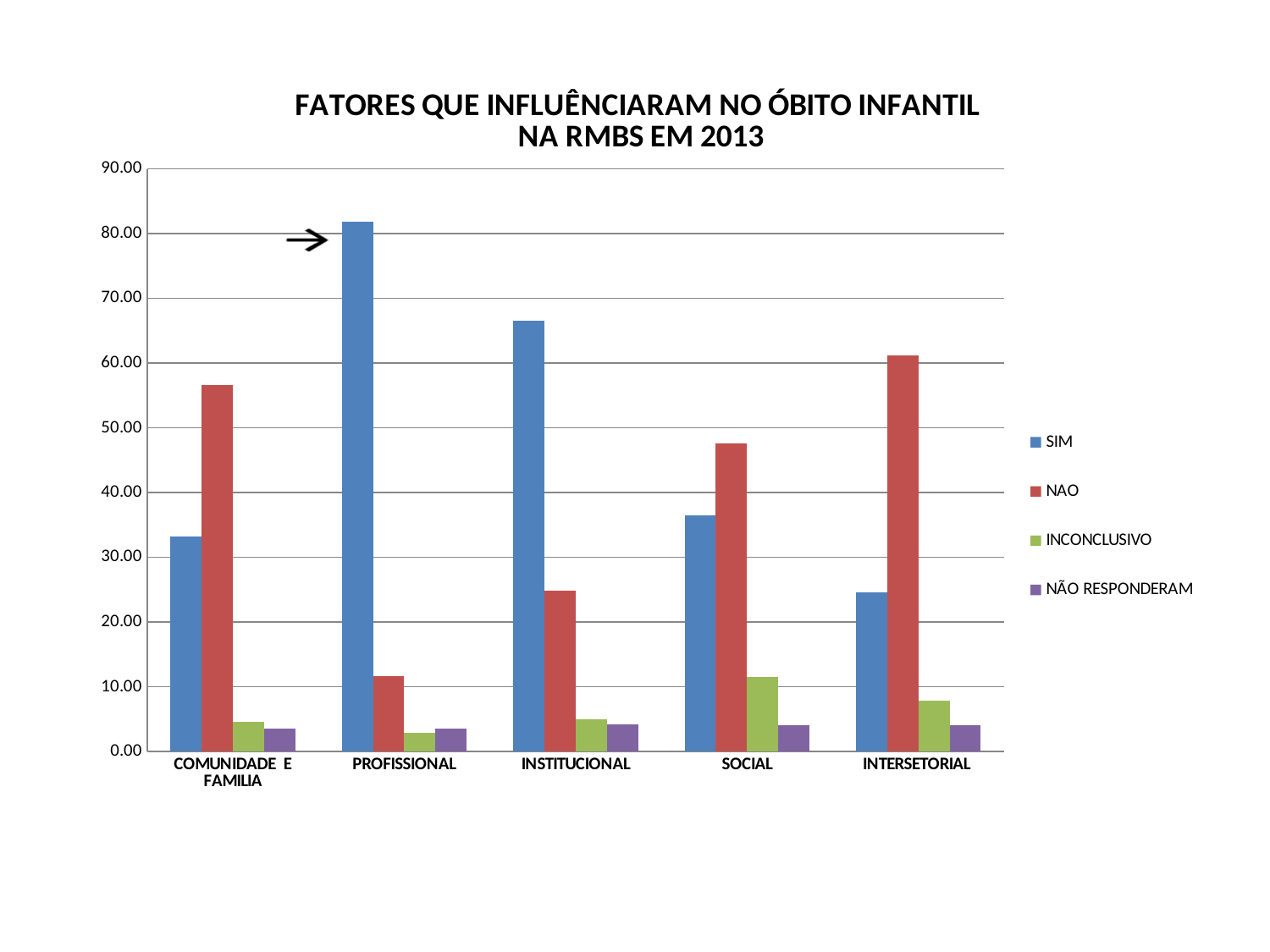
Is the SIM value for PROFISSIONAL greater or less than 70.00? greater For COMUNIDADE E FAMILIA, which is larger, SIM or NAO? NAO Which category has the lowest SIM value? INTERSETORIAL For INSTITUCIONAL, which is larger, SIM or NAO? SIM Which category has the highest SIM value? PROFISSIONAL What is the title of the chart? FATORES QUE INFLUÊNCIARAM NO ÓBITO INFANTIL NA RMBS EM 2013 What kind of chart is shown on the slide? bar chart How many categories are shown on the x axis? 5 Which category has the highest INCONCLUSIVO value? SOCIAL How many series does the legend list? 4 Is the NAO value for PROFISSIONAL greater or less than 20.00? less Which category has the highest NAO value? INTERSETORIAL